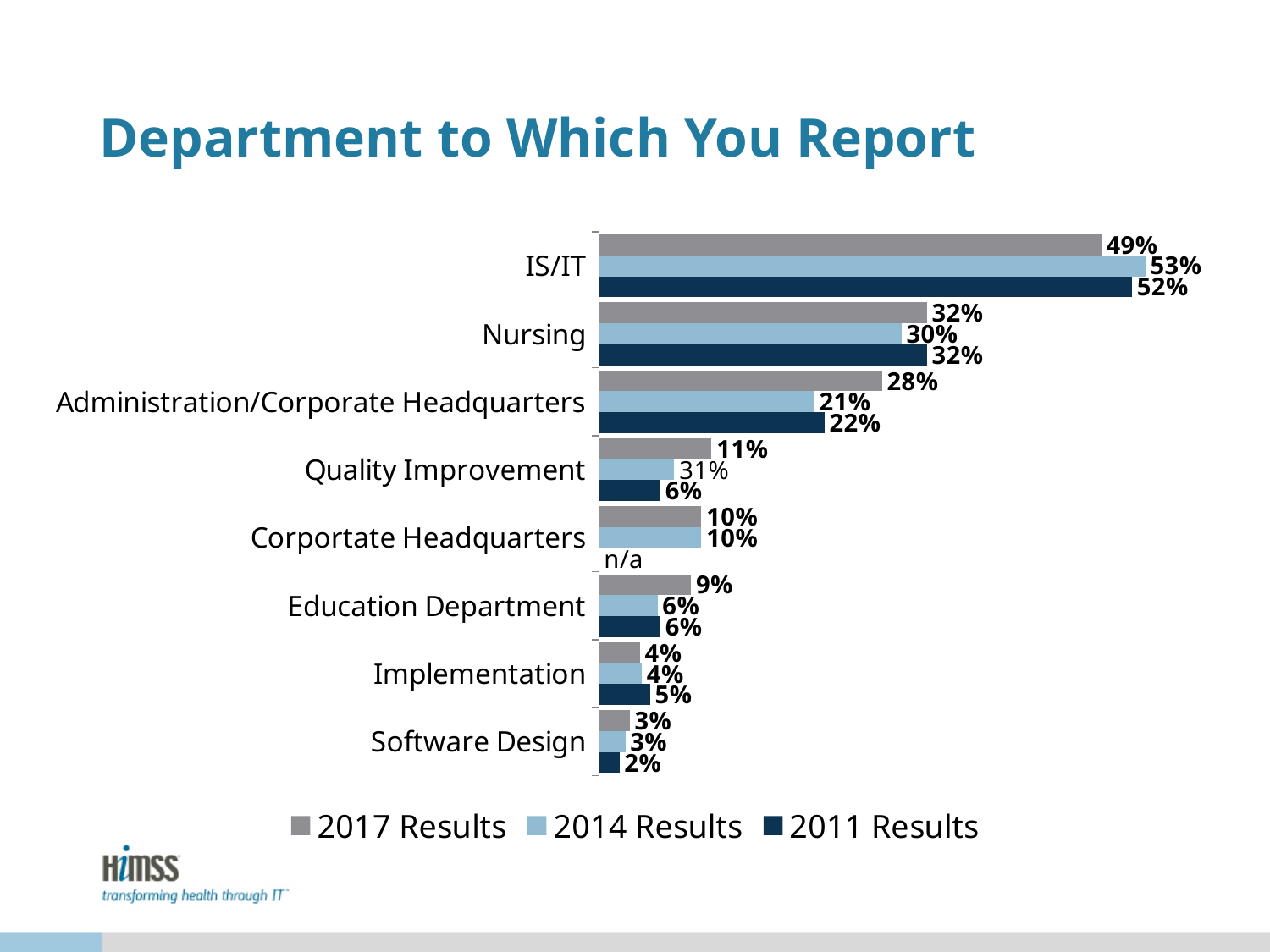
How many departments are shown on the chart? 8 What is the 2014 Results value for IS/IT? 53% What is the difference between the 2017 and 2014 Results values for Administration/Corporate Headquarters? 7% What is the 2011 Results value for Implementation? 5% Which department has the lowest 2011 Results value? Software Design What is the title of the chart? Department to Which You Report What is the 2017 Results value for Administration/Corporate Headquarters? 28% Which department has the highest 2017 Results value? IS/IT What kind of chart is shown on the slide? bar chart Which is larger for Nursing, the 2017 Results value or the 2014 Results value? 2017 Results What is shown for the 2011 Results value of Corportate Headquarters? n/a How many series does the legend list? 3